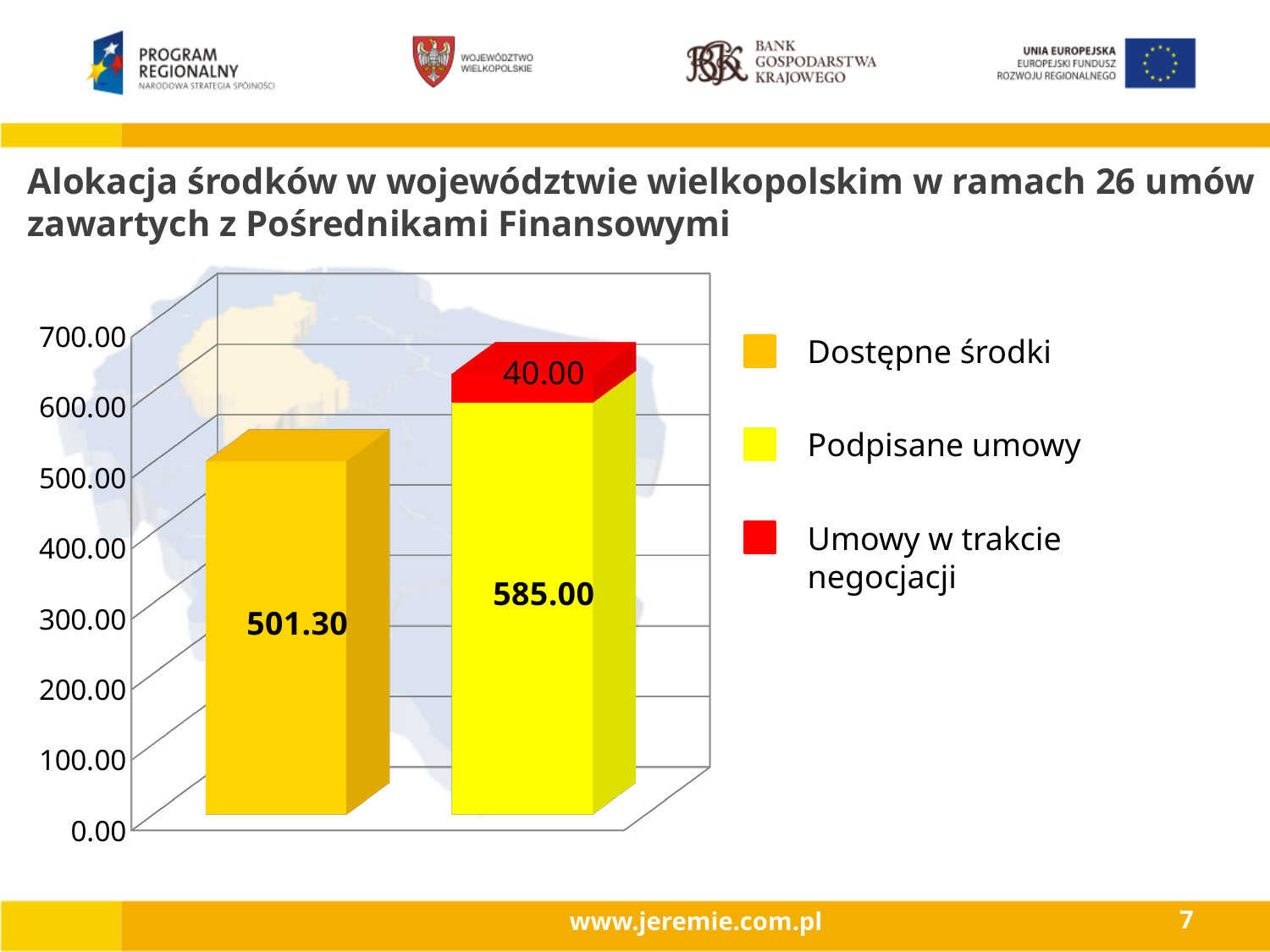
What value is shown for Dostępne środki? 501.30 Which is larger, Podpisane umowy or Dostępne środki? Podpisane umowy How many entries does the legend list? 3 What is the difference between Podpisane umowy and Dostępne środki? 83.70 What colour represents Umowy w trakcie negocjacji in the chart? red What value is shown for Podpisane umowy? 585.00 What value is shown for Umowy w trakcie negocjacji? 40.00 Is the value for Dostępne środki greater or less than 600.00? less What kind of chart is shown on the slide? bar chart Which legend entry has the largest value? Podpisane umowy Which legend entry has the smallest value? Umowy w trakcie negocjacji What is the total of the stacked bar made up of Podpisane umowy and Umowy w trakcie negocjacji? 625.00